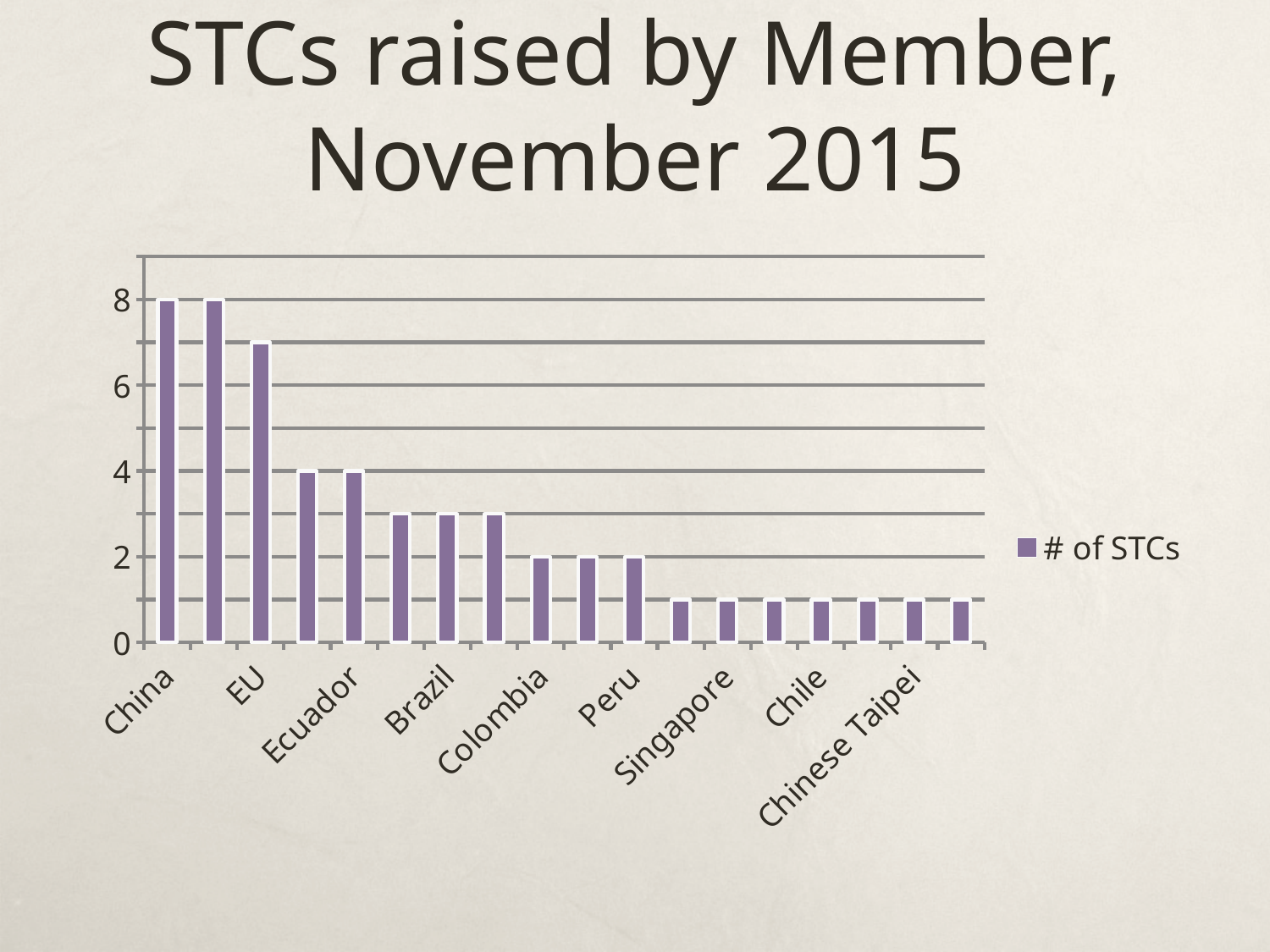
Which has a larger value, EU or Ecuador? EU What is the value for China? 8 What is the value for Brazil? 3 What is the difference between the values for China and EU? 1 What is the value for EU? 7 What kind of chart is shown on the slide? bar chart Is the value for Chile greater or less than 2? less Do the values generally rise or fall from left to right along the x axis? fall What is the value for Ecuador? 4 What is the value for Singapore? 1 What is the value for Colombia? 2 What series does the legend list? # of STCs